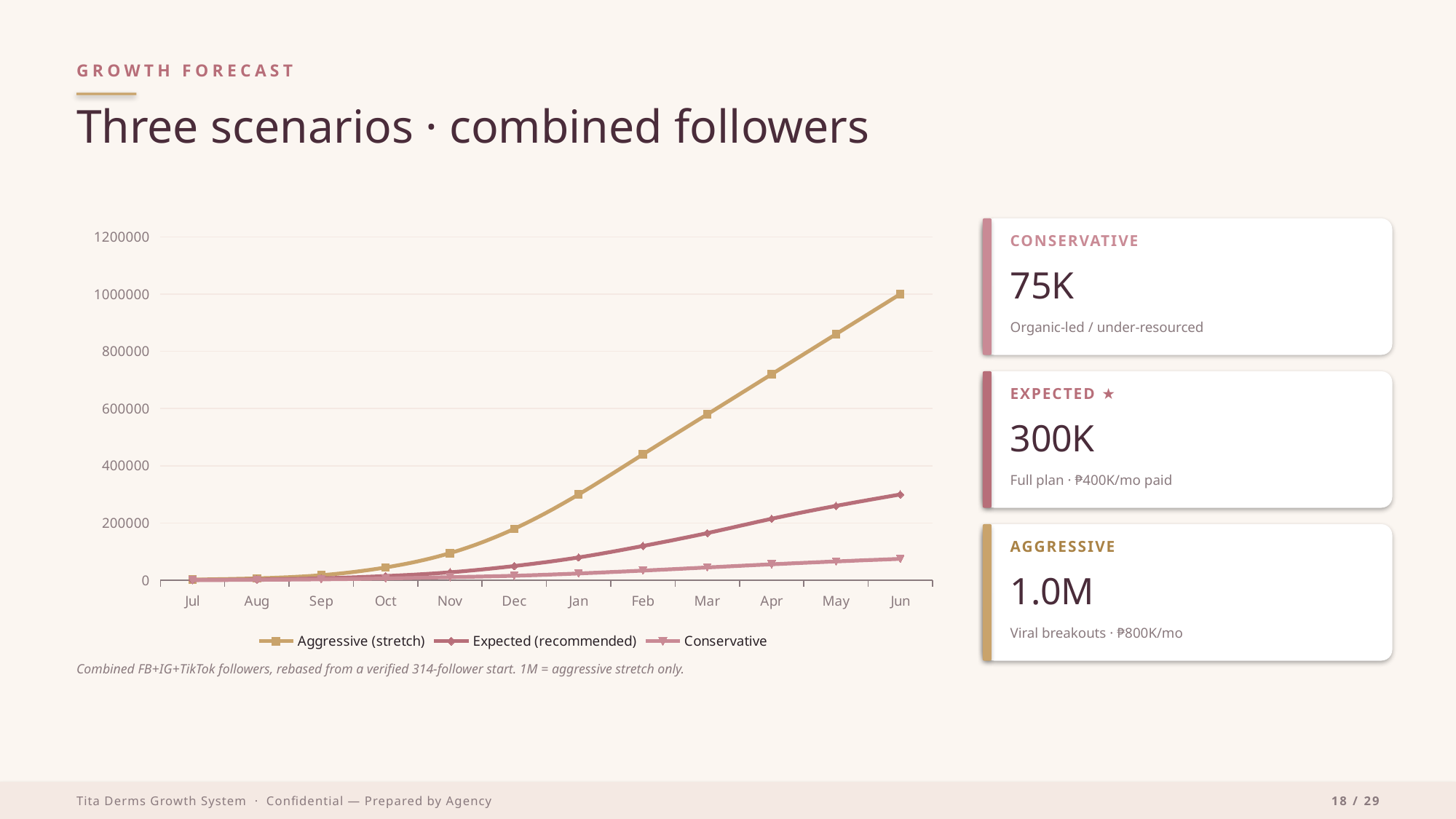
Which is larger in Apr, the Aggressive (stretch) value or the Expected (recommended) value? Aggressive (stretch) Which series has the highest value in Jun? Aggressive (stretch) How many months are plotted along the x axis? 12 Which series is drawn in the gold/tan colour? Aggressive (stretch) Is the value for Aggressive (stretch) in Mar greater or less than 400000? greater Is the value for Expected (recommended) in Jun greater or less than 400000? less Do the values of the Aggressive (stretch) series rise or fall from Jul to Jun? rise What is the value of the Aggressive (stretch) series in Jun? 1000000 What kind of chart is shown on the slide? line chart How many series does the chart legend list? 3 Is the value for Aggressive (stretch) in Jan greater or less than 200000? greater Which series has the lowest value in Jun? Conservative